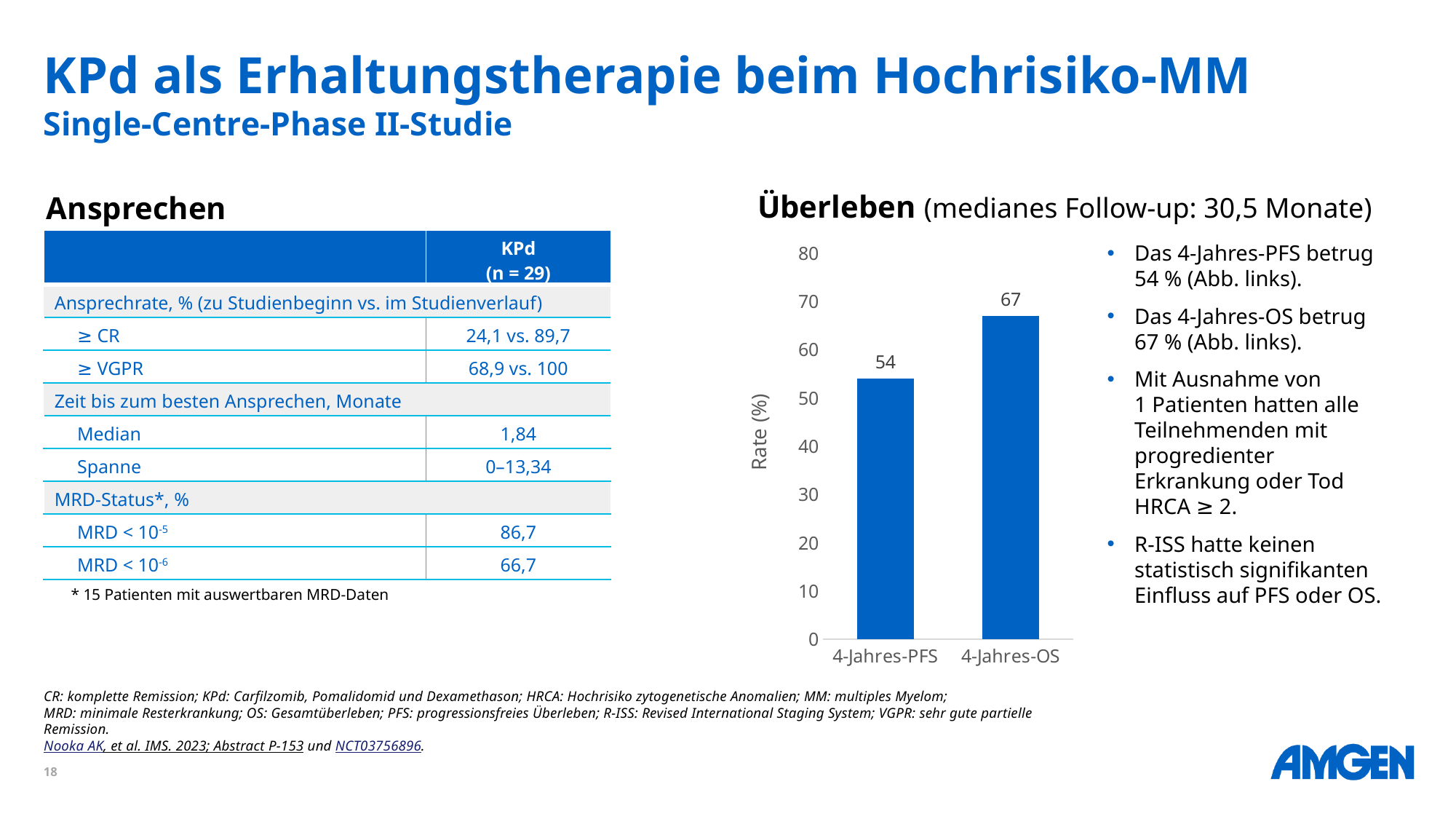
Is the value for 4-Jahres-PFS greater or less than 60? less What is the value for 4-Jahres-PFS in the chart? 54 What is the value for 4-Jahres-OS in the chart? 67 What is the label of the y axis of the chart? Rate (%) What kind of chart is shown on the slide? bar chart Which category has the highest value in the chart? 4-Jahres-OS What is the maximum value shown on the y axis of the chart? 80 Is the value for 4-Jahres-OS greater or less than 60? greater Which is larger, the value for 4-Jahres-PFS or for 4-Jahres-OS? 4-Jahres-OS Which category has the lowest value in the chart? 4-Jahres-PFS How many categories are shown in the chart? 2 What is the difference between the 4-Jahres-OS and 4-Jahres-PFS values? 13